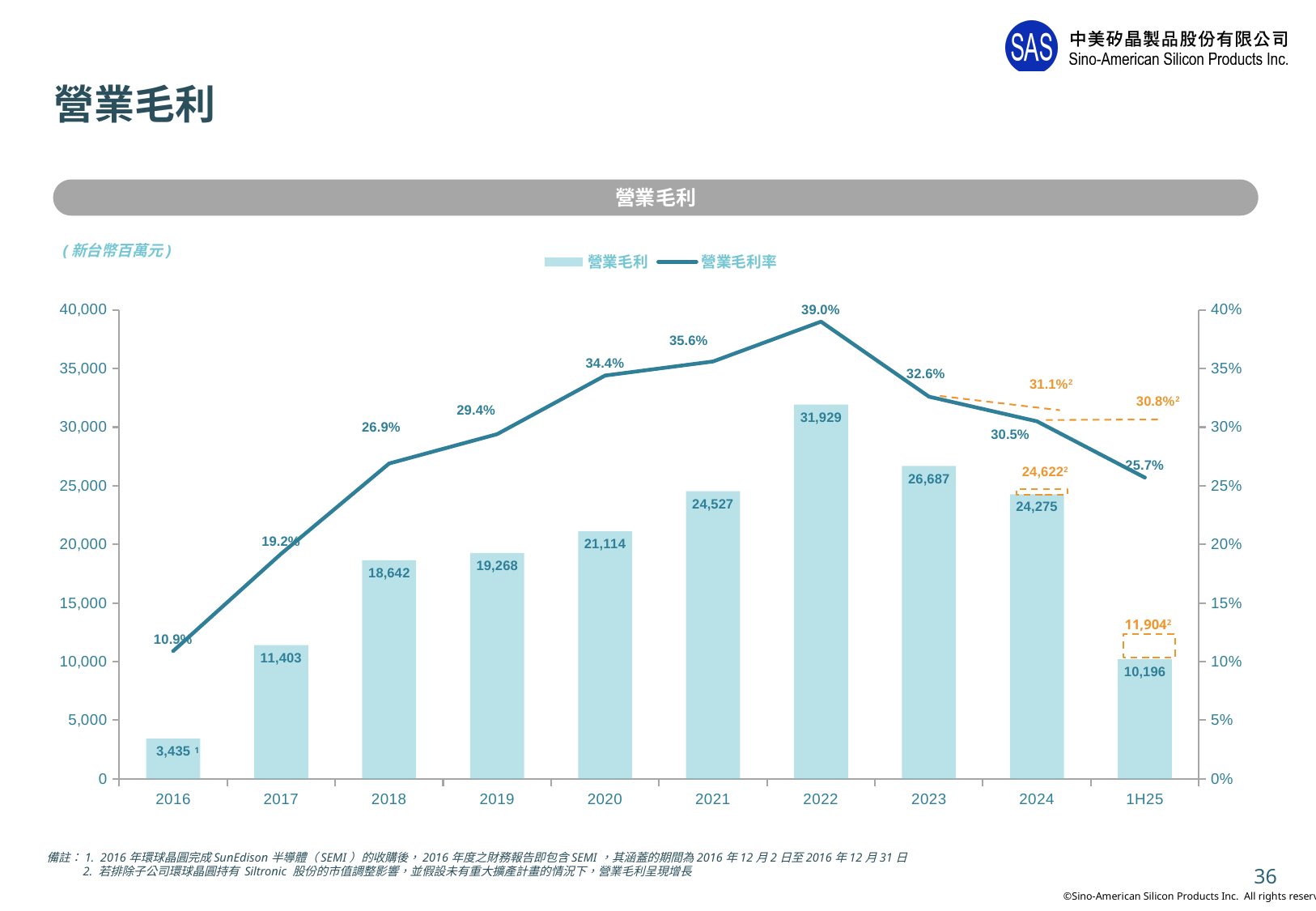
What is the 營業毛利 value for 1H25? 10,196 Does the 營業毛利率 line rise or fall from 2016 to 2022? rise How many categories are shown on the x axis? 10 What is the difference in 營業毛利 between 2023 and 2024? 2,412 Which category has the lowest 營業毛利 bar? 2016 What unit is stated for the chart values? 新台幣百萬元 Which is larger, the 營業毛利 for 2019 or for 2018? 2019 What is the 營業毛利率 for 2020? 34.4% Which year has the highest 營業毛利率? 2022 How many series does the legend list? 2 What is the 營業毛利 value for 2022? 31,929 Is the 營業毛利 value for 2021 greater or less than 25,000? less